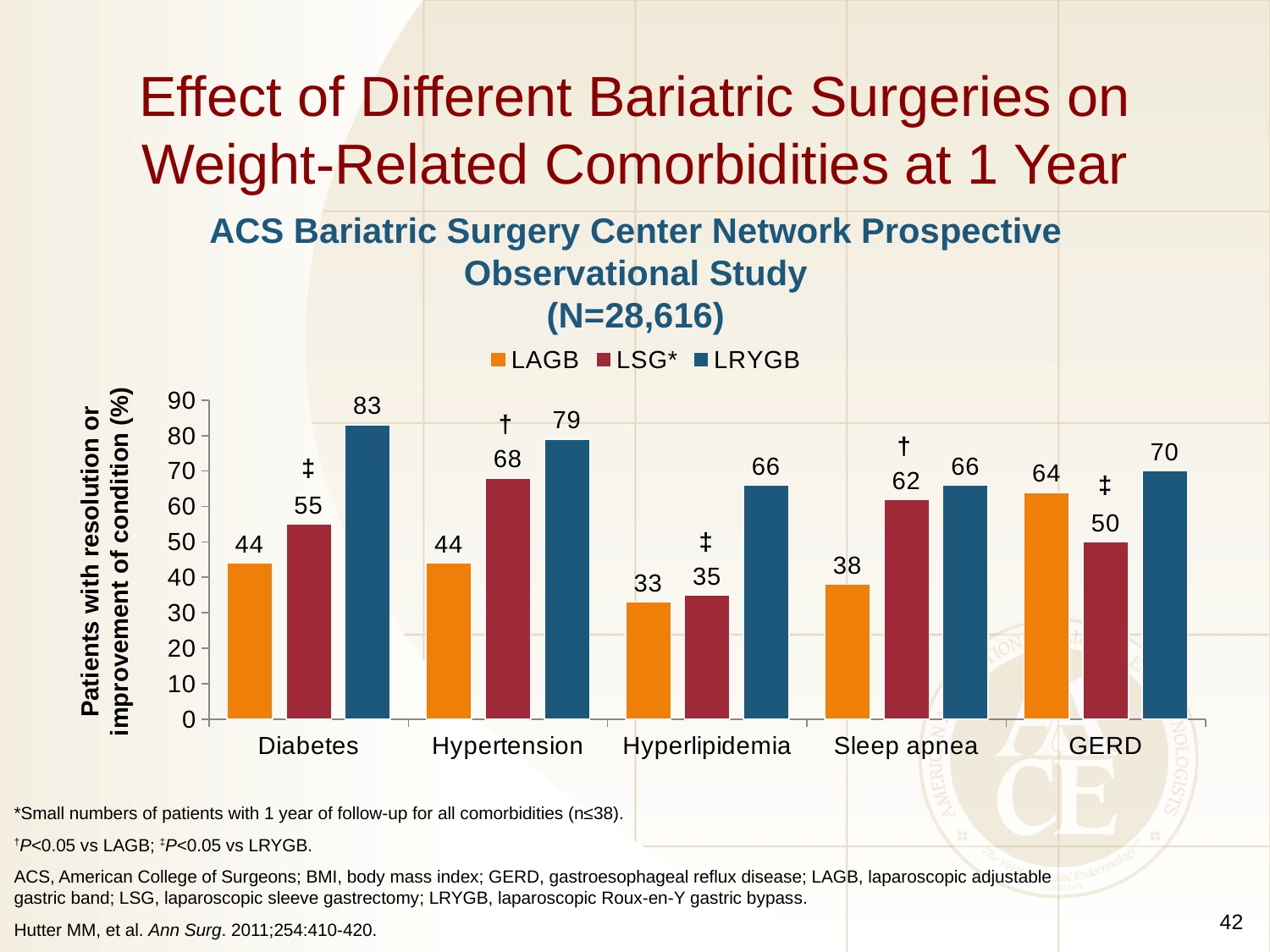
For GERD, which is larger: the LAGB value or the LSG* value? LAGB What kind of chart is shown on the slide? Bar chart Which category has the highest LRYGB value? Diabetes How many series does the legend list? 3 What is the difference between the LRYGB and LAGB values for Diabetes? 39 What is the LSG* value for Hypertension? 68 Which category has the lowest LAGB value? Hyperlipidemia What is the label of the y axis? Patients with resolution or improvement of condition (%) How many comorbidity categories are shown on the x axis? 5 Is the LSG* value for Sleep apnea greater or less than 50? greater What is the LRYGB value for Diabetes? 83 What is the LAGB value for GERD? 64